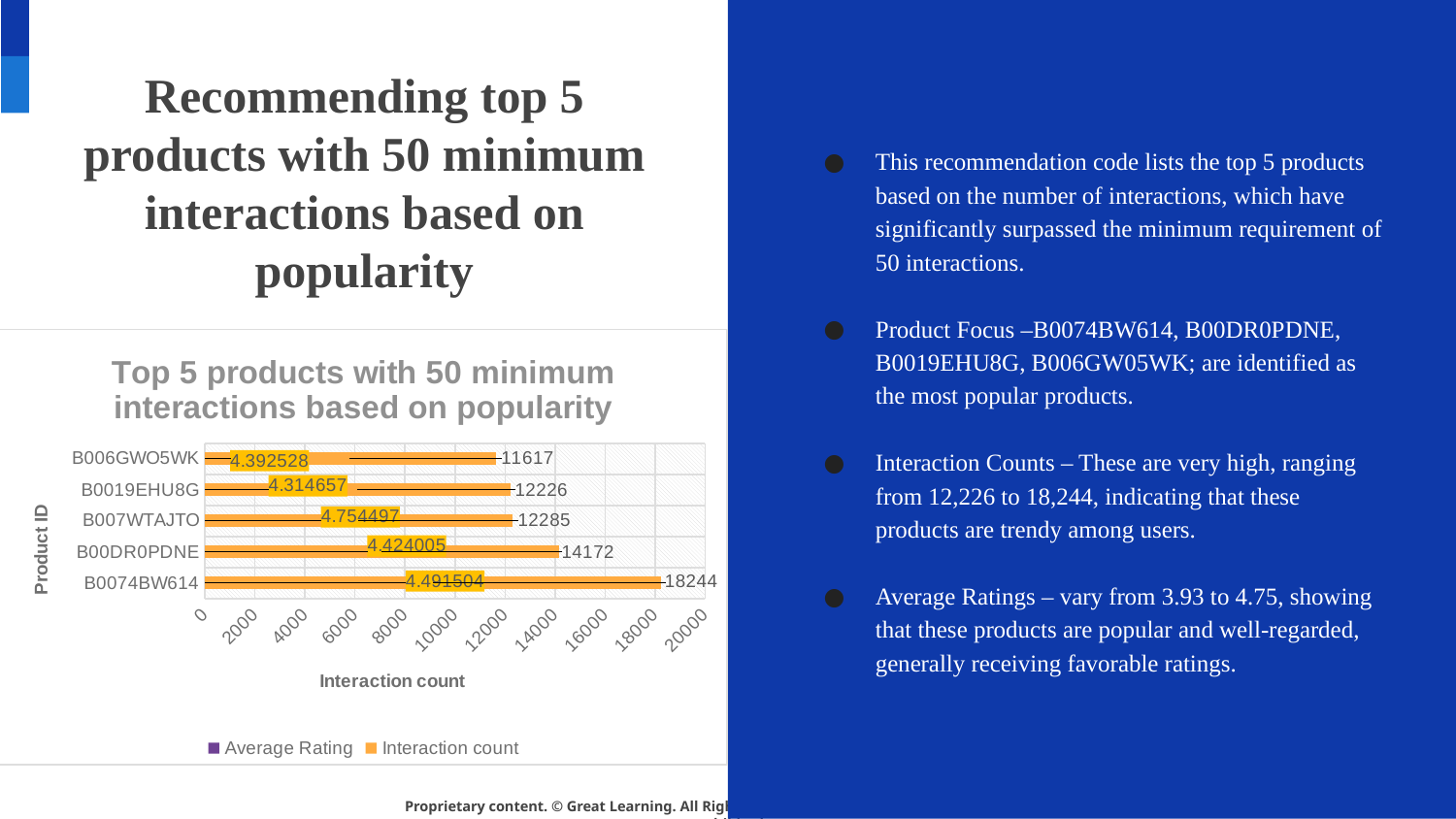
Which product has the highest interaction count? B0074BW614 How many series does the legend list? 2 Which product has the lowest interaction count? B006GWO5WK What is the interaction count for product B006GWO5WK? 11617 What is the interaction count for product B0074BW614? 18244 What type of chart is shown on the slide? bar chart How many products are shown in the chart? 5 What is the difference in interaction count between B0074BW614 and B00DR0PDNE? 4072 Which product has a higher interaction count, B0019EHU8G or B00DR0PDNE? B00DR0PDNE What is the label of the horizontal axis of the chart? Interaction count What is the average rating for product B00DR0PDNE? 4.424005 What is the average rating for product B007WTAJTO? 4.754497